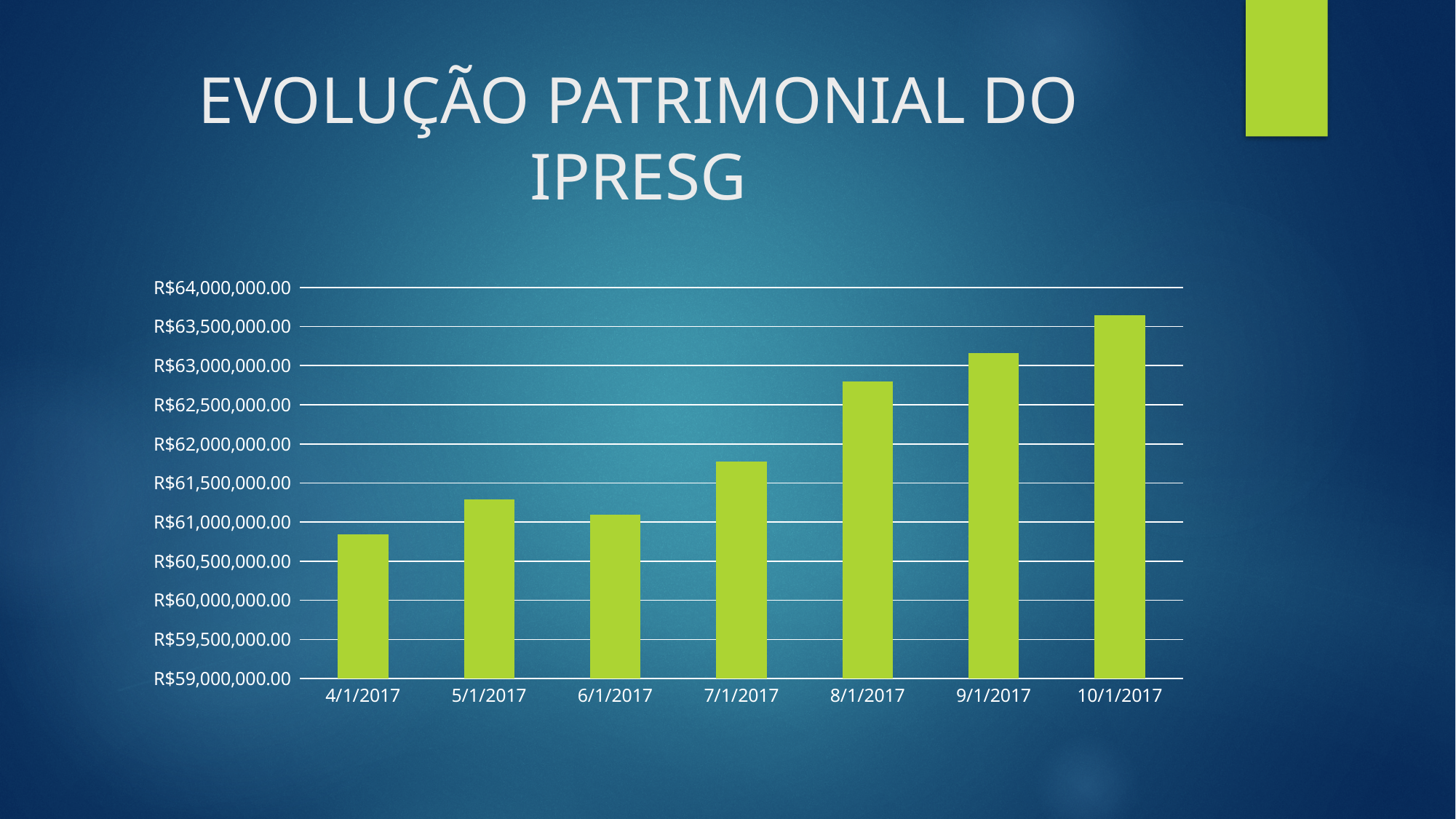
Is the value for 4/1/2017 greater or less than R$61,000,000.00? less Is the value for 8/1/2017 greater or less than R$62,500,000.00? greater Which date has the lowest value in the chart? 4/1/2017 Do the values generally rise or fall from left to right along the x axis? Rise Which date has the highest value in the chart? 10/1/2017 How many dates are plotted along the x axis of the chart? 7 What is the title of the slide containing the chart? EVOLUÇÃO PATRIMONIAL DO IPRESG Which is larger, the value for 5/1/2017 or the value for 6/1/2017? 5/1/2017 Is the value for 10/1/2017 greater or less than R$63,500,000.00? greater What kind of chart is shown on the slide? Bar chart Which is larger, the value for 7/1/2017 or the value for 8/1/2017? 8/1/2017